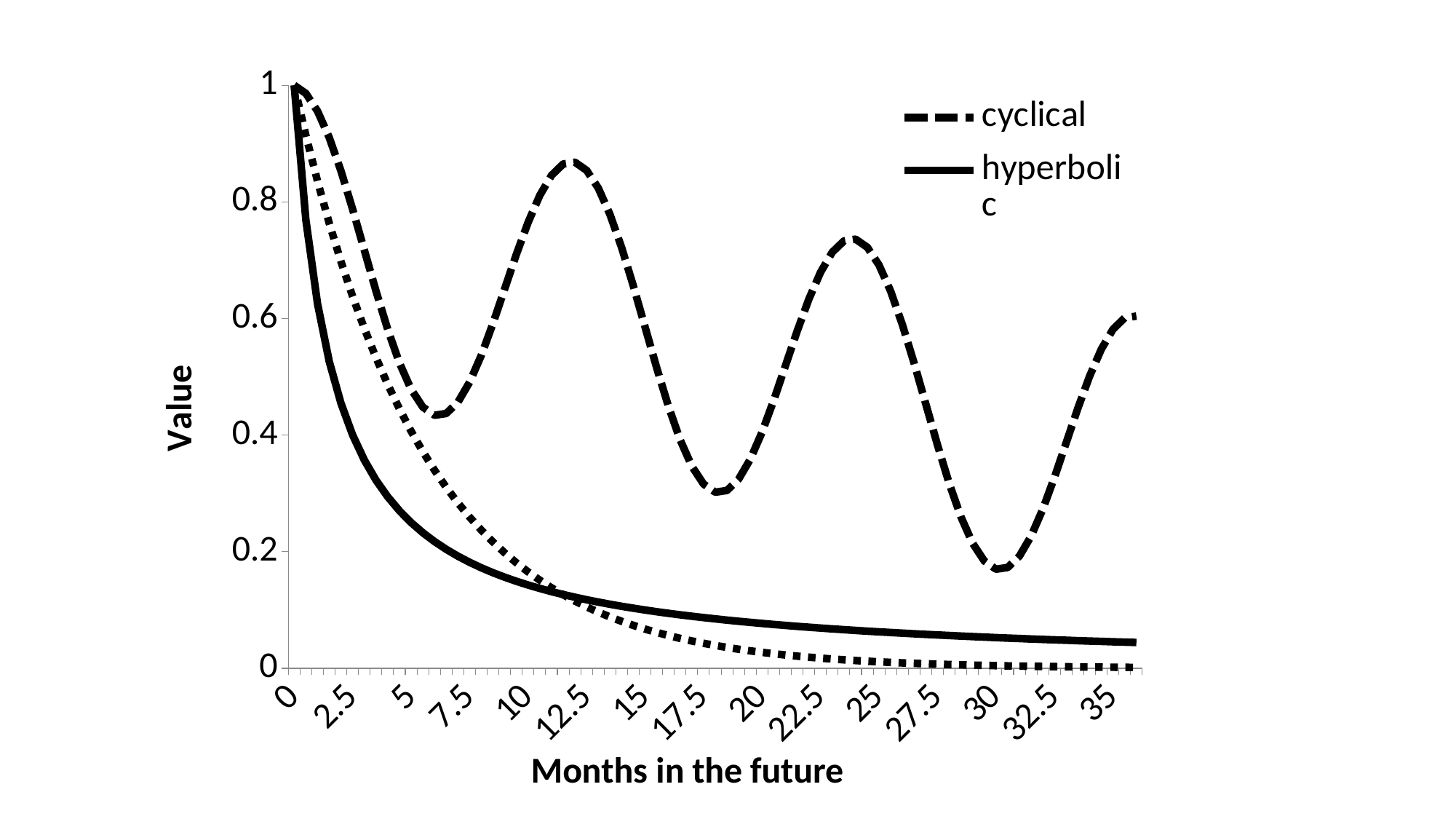
How many series does the legend list? 2 What is the title of the x axis? Months in the future Does the hyperbolic series rise or fall as months in the future increase? fall At month 25, which series has the larger value, cyclical or hyperbolic? cyclical What is the title of the y axis? Value Is the value of the hyperbolic series at month 5 greater or less than 0.4? less Is the value of the cyclical series at month 12.5 greater or less than 0.8? greater Is the value of the cyclical series at month 22.5 greater or less than 0.6? greater What kind of chart is shown on the slide? line chart What is the value of the hyperbolic series at month 0? 1